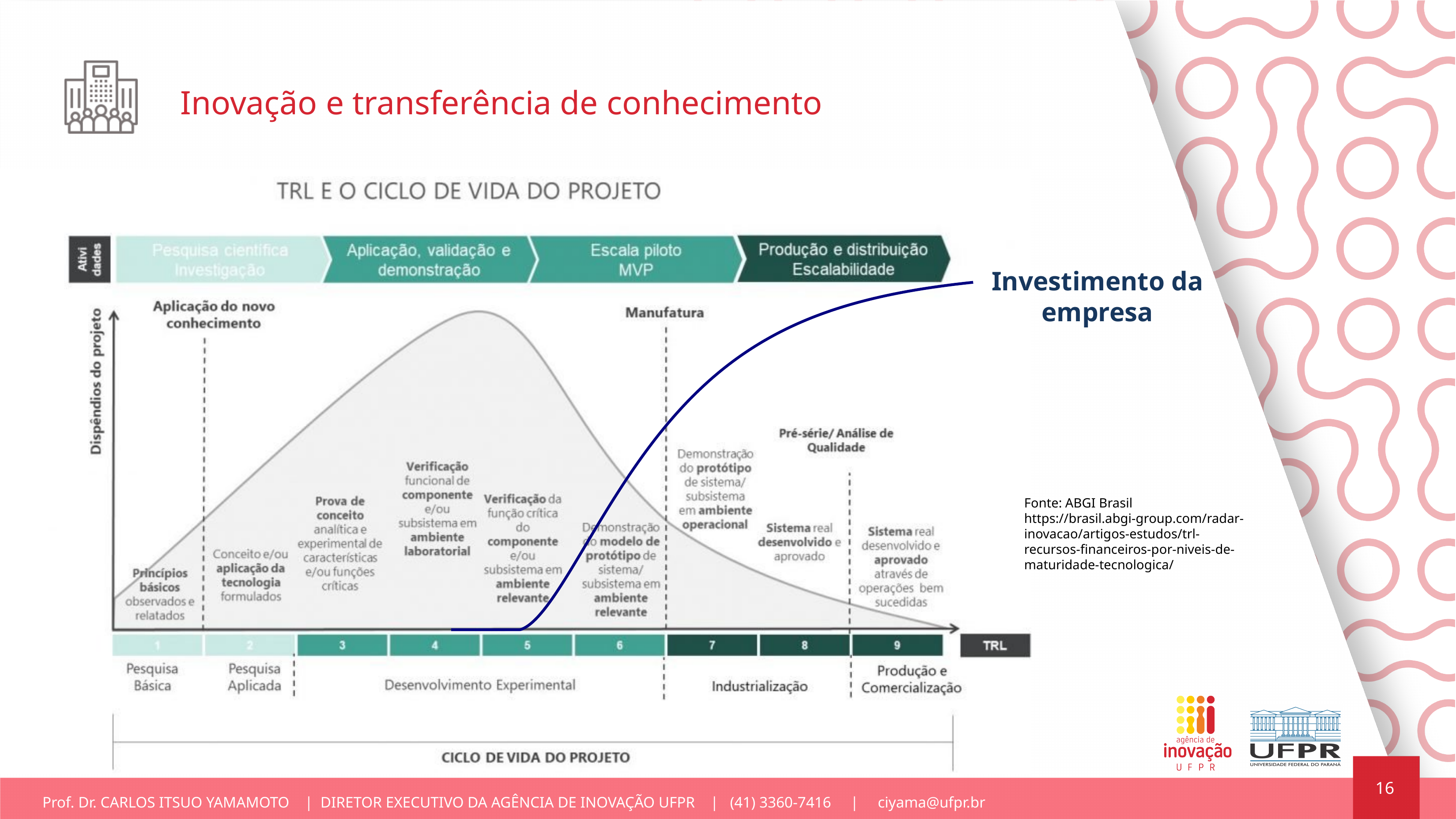
In which phase of the project life cycle does the grey expenditure curve reach its peak? Desenvolvimento Experimental What is the label on the vertical axis of the chart? Dispêndios do projeto Which TRL levels fall under the 'Industrialização' phase on the chart? 7 and 8 Does the grey project expenditure curve rise or fall from TRL 6 to TRL 9? falls Which TRL levels fall under the 'Desenvolvimento Experimental' phase on the chart? 3 to 6 How many TRL levels are shown along the horizontal axis of the chart? 9 What kind of chart is shown on the slide? line chart Is the grey expenditure curve higher at TRL 4 or at TRL 8? TRL 4 What is the title of the chart on the slide? TRL E O CICLO DE VIDA DO PROJETO Does the grey project expenditure curve rise or fall from TRL 1 to TRL 4? rises Does the blue 'Investimento da empresa' curve rise or fall as TRL increases? rises How many activity bands (Atividades) are shown across the top of the chart? 4